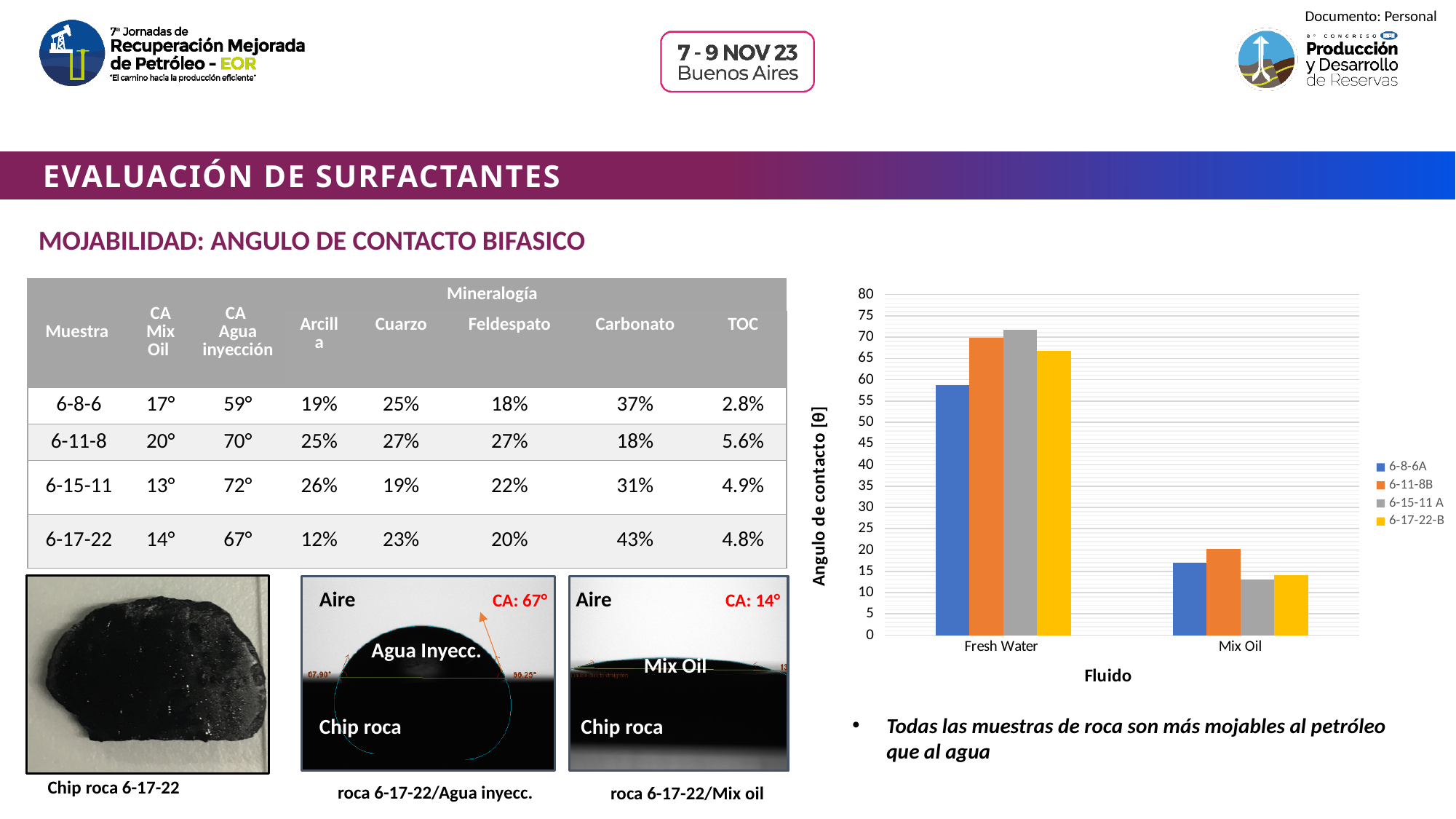
What is the label of the x axis of the bar chart? Fluido In the bar chart, which series has the highest contact angle for Mix Oil? 6-11-8B What is the label of the y axis of the bar chart? Angulo de contacto [θ] In the bar chart, which is larger for series 6-8-6A: the Fresh Water value or the Mix Oil value? Fresh Water In the bar chart, is the Fresh Water value for 6-17-22-B greater or less than 60? greater In the bar chart, which series has the lowest contact angle for Fresh Water? 6-8-6A In the bar chart, which series has the lowest contact angle for Mix Oil? 6-15-11 A In the bar chart, is the Mix Oil value for 6-8-6A greater or less than 20? less How many fluid categories are shown on the x axis of the bar chart? 2 What kind of chart is shown on the right side of the slide? bar chart How many series does the legend of the bar chart list? 4 In the bar chart, which series has the highest contact angle for Fresh Water? 6-15-11 A